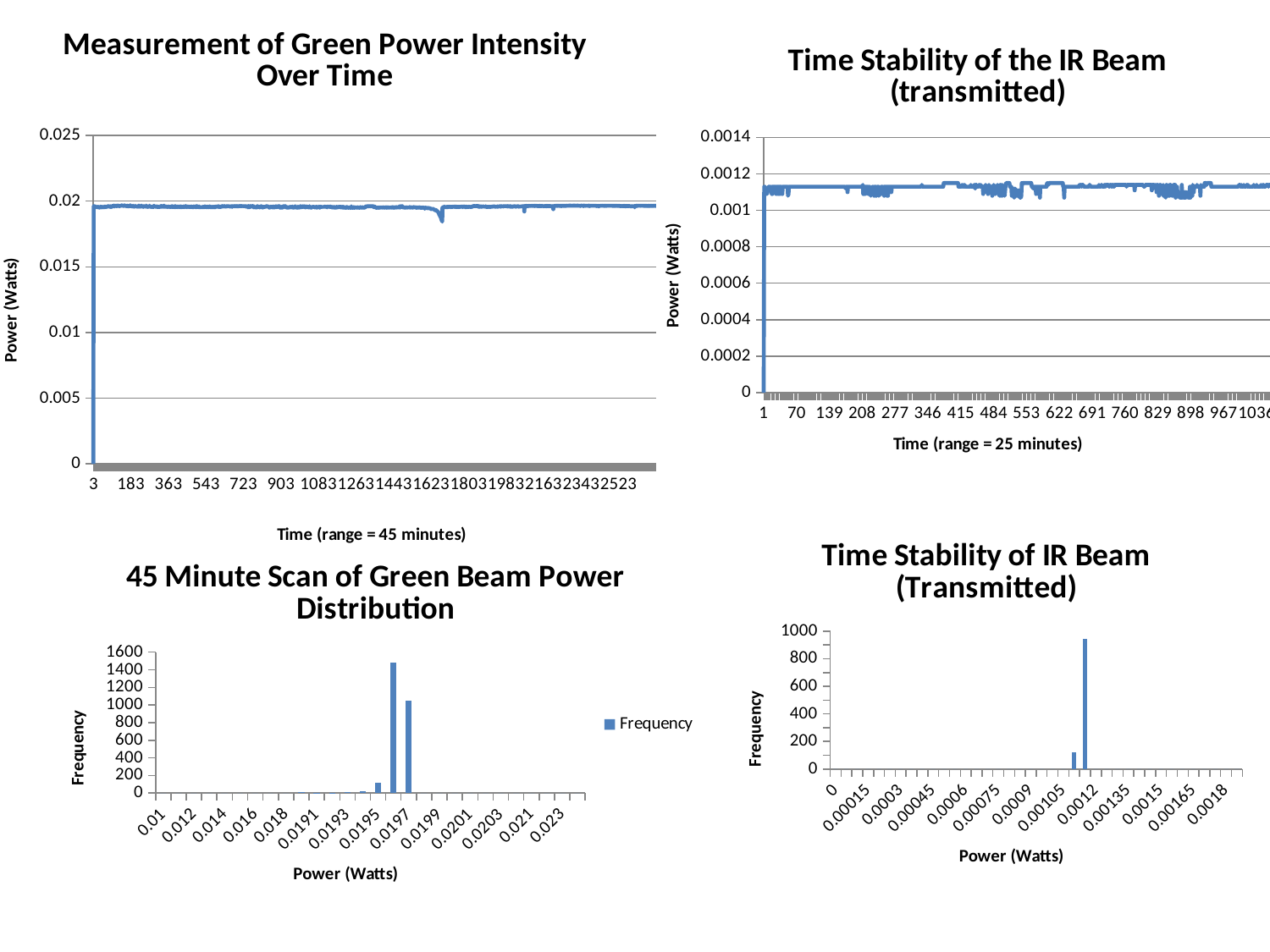
How many series does the legend of the '45 Minute Scan of Green Beam Power Distribution' chart list? 1 What is the y-axis title of the 'Measurement of Green Power Intensity Over Time' chart? Power (Watts) In the 'Time Stability of IR Beam (Transmitted)' bar chart, is the frequency of the tallest bar greater or less than 800? greater What kind of chart is the '45 Minute Scan of Green Beam Power Distribution' chart? bar chart In the 'Time Stability of the IR Beam (transmitted)' line chart, is the power value after the initial rise greater or less than 0.0012 Watts? less In the 'Time Stability of the IR Beam (transmitted)' line chart, is the power value after the initial rise greater or less than 0.0008 Watts? greater What kind of chart is the 'Measurement of Green Power Intensity Over Time' chart? line chart What is the x-axis title of the 'Time Stability of the IR Beam (transmitted)' line chart? Time (range = 25 minutes)